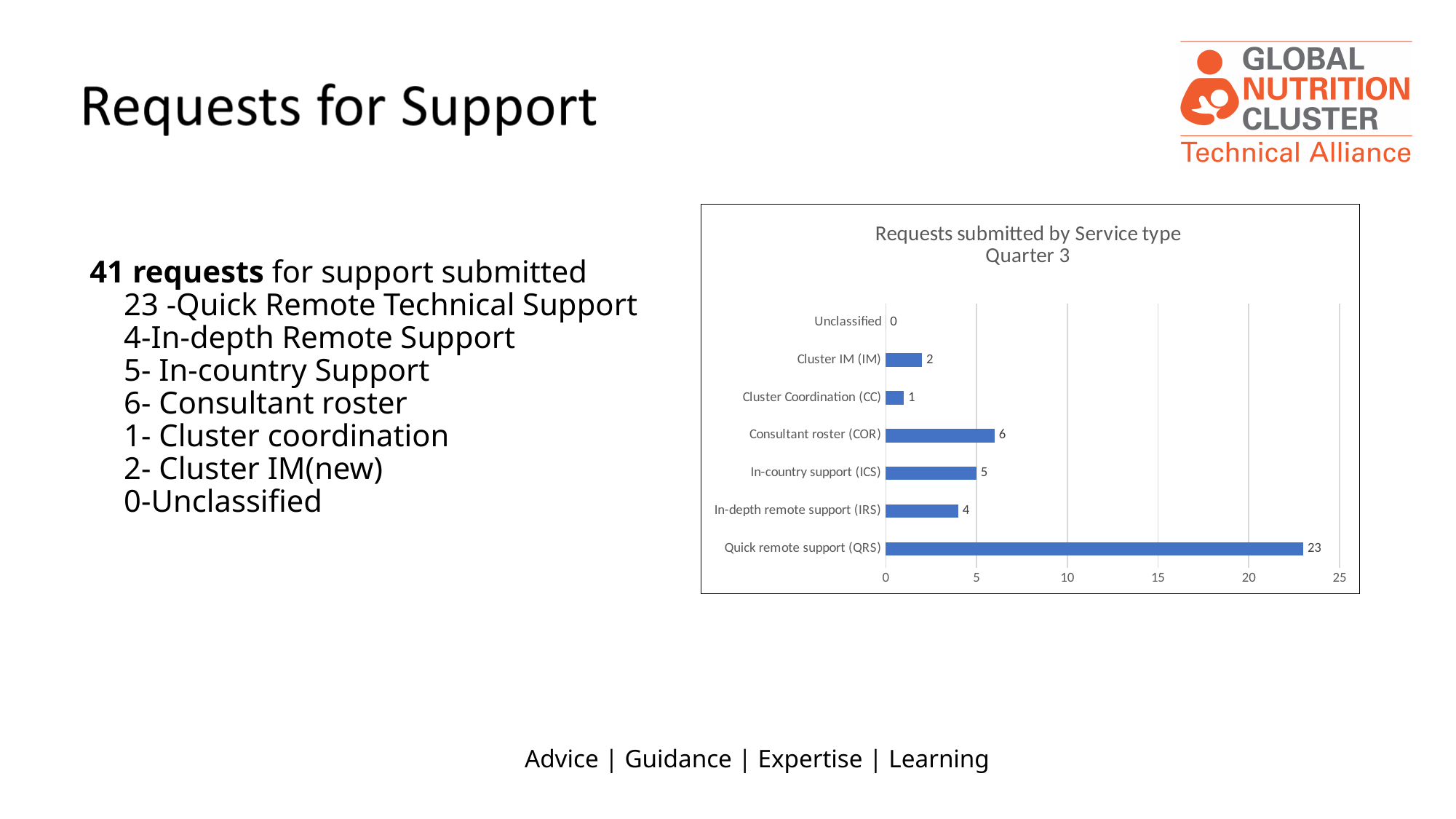
What is the title of the chart? Requests submitted by Service type Quarter 3 What kind of chart is shown on the slide? Bar chart Which service type has the highest number of requests? Quick remote support (QRS) Which is larger, In-country support (ICS) or In-depth remote support (IRS)? In-country support (ICS) What is the value for Quick remote support (QRS)? 23 Is the value for Quick remote support (QRS) greater or less than 20? greater What is the value for Cluster IM (IM)? 2 Which service type has the lowest number of requests? Unclassified What is the value for Consultant roster (COR)? 6 What is the value for In-depth remote support (IRS)? 4 How many service type categories are shown in the chart? 7 What is the difference between Quick remote support (QRS) and Consultant roster (COR)? 17